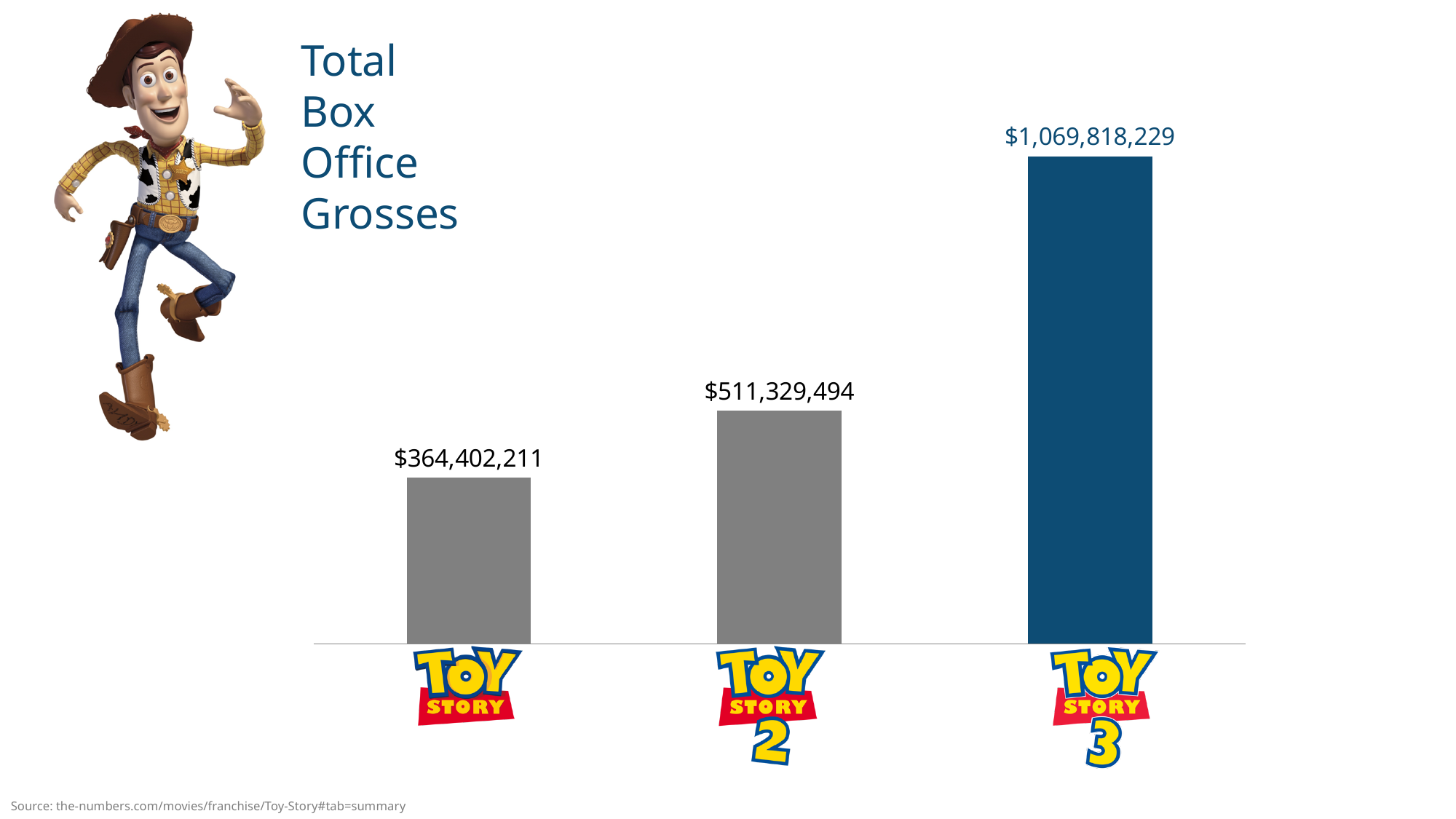
How much larger is the gross for Toy Story 3 than for Toy Story 2? $558,488,735 What is the total box office gross shown for Toy Story 2? $511,329,494 What is the total box office gross shown for Toy Story 3? $1,069,818,229 What is the title of the chart? Total Box Office Grosses Which grossed more, Toy Story or Toy Story 2? Toy Story 2 What is the difference between the grosses of Toy Story 2 and Toy Story? $146,927,283 What is the total box office gross shown for Toy Story? $364,402,211 Do the box office grosses rise or fall from Toy Story to Toy Story 3? Rise Which film has the lowest total box office gross on the chart? Toy Story What kind of chart is shown on the slide? Bar chart Which film has the highest total box office gross on the chart? Toy Story 3 How many films are shown on the chart? 3